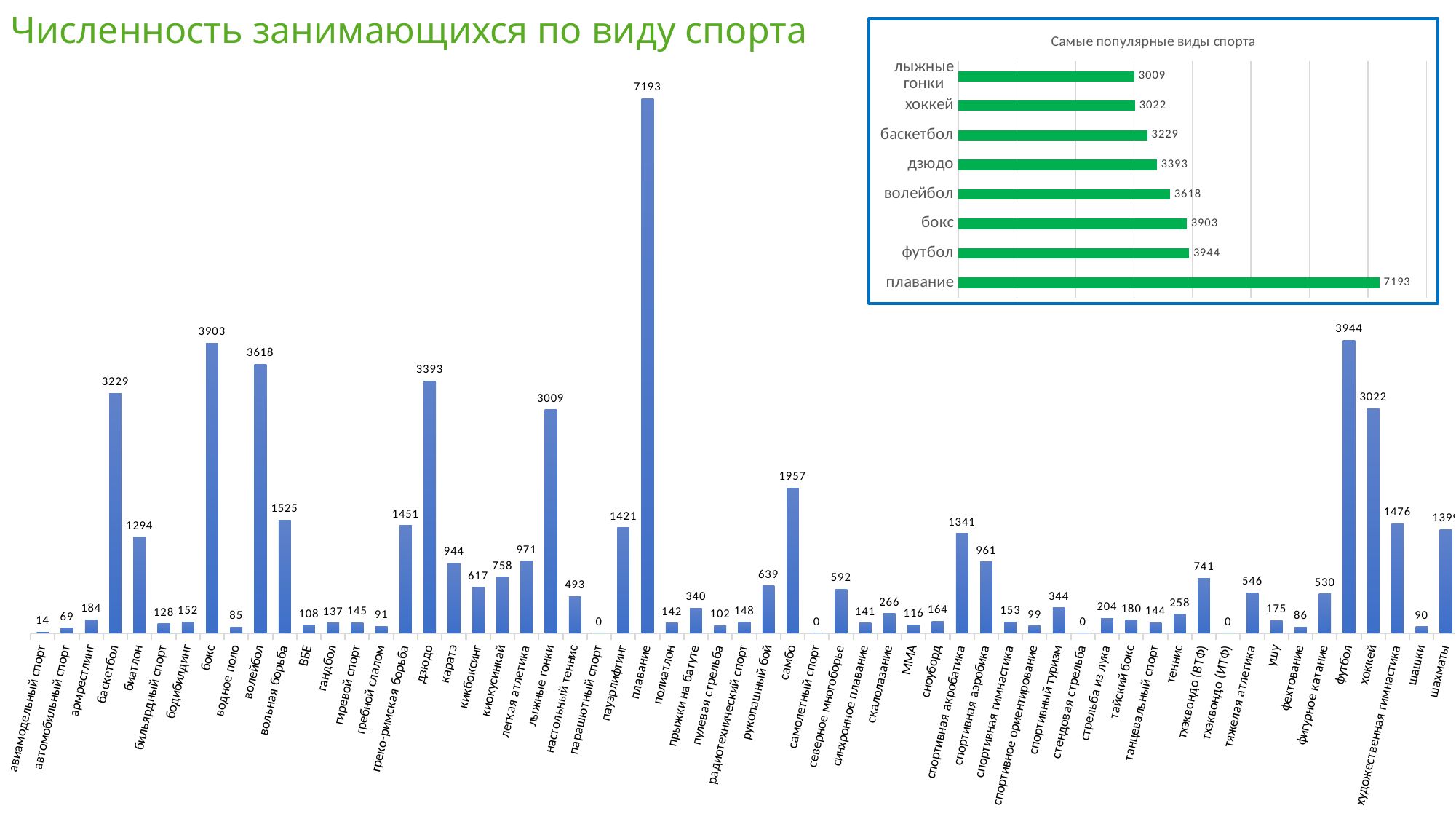
In the chart 'Численность занимающихся по виду спорта', what is the value for биатлон? 1294 In the chart 'Численность занимающихся по виду спорта', which is larger, теннис or тхэквондо (ВТФ)? тхэквондо (ВТФ) In the chart 'Самые популярные виды спорта', which sport has the lowest value? лыжные гонки In the chart 'Численность занимающихся по виду спорта', what is the value for самбо? 1957 In the chart 'Самые популярные виды спорта', how many sports are listed? 8 In the chart 'Самые популярные виды спорта', what is the difference between футбол and бокс? 41 In the chart 'Численность занимающихся по виду спорта', what is the difference between хоккей and лыжные гонки? 13 In the chart 'Самые популярные виды спорта', what is the value for плавание? 7193 What kind of chart is 'Численность занимающихся по виду спорта'? bar chart In the chart 'Численность занимающихся по виду спорта', which sport has the highest value? плавание In the chart 'Самые популярные виды спорта', which is larger, волейбол or дзюдо? волейбол What is the title of the small inset chart on the slide? Самые популярные виды спорта